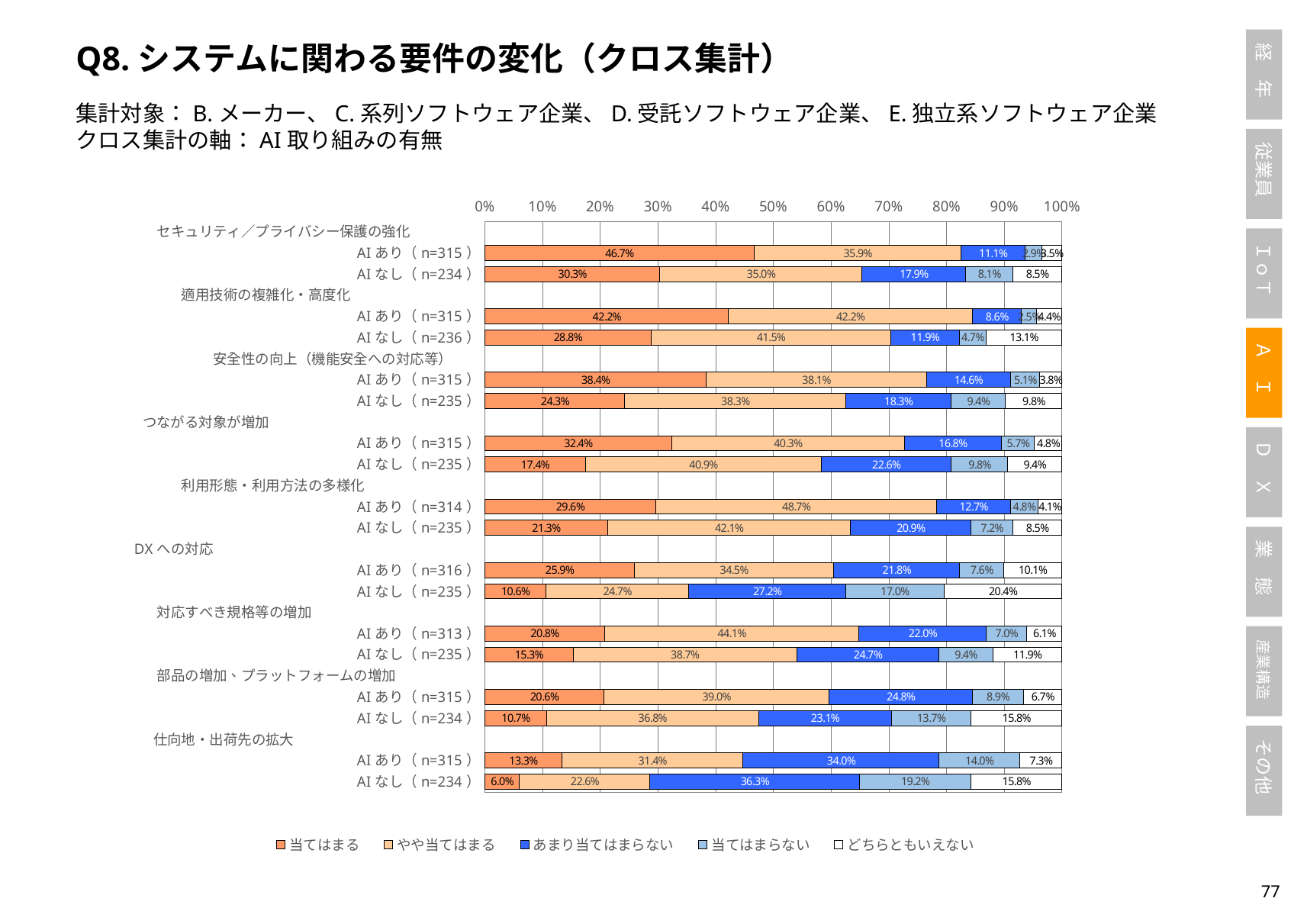
How many series does the legend list? 5 What is the 当てはまる value for セキュリティ／プライバシー保護の強化, AI なし (n=234)? 30.3% Which bar has the lowest 当てはまる value? 仕向地・出荷先の拡大 AI なし (6.0%) What is the どちらともいえない value for DX への対応, AI なし (n=235)? 20.4% For 適用技術の複雑化・高度化, which has the larger 当てはまる value, AI あり or AI なし? AI あり How many bars (AI あり / AI なし rows) are plotted in the chart? 18 What is the difference in 当てはまる between AI あり and AI なし for セキュリティ／プライバシー保護の強化? 16.4 percentage points Which bar has the highest 当てはまる value? セキュリティ／プライバシー保護の強化 AI あり (46.7%) What is the やや当てはまる value for 利用形態・利用方法の多様化, AI あり (n=314)? 48.7% What is the あまり当てはまらない value for 仕向地・出荷先の拡大, AI なし (n=234)? 36.3% What is the 当てはまる value for セキュリティ／プライバシー保護の強化, AI あり (n=315)? 46.7% What kind of chart is shown on the slide? Stacked bar chart